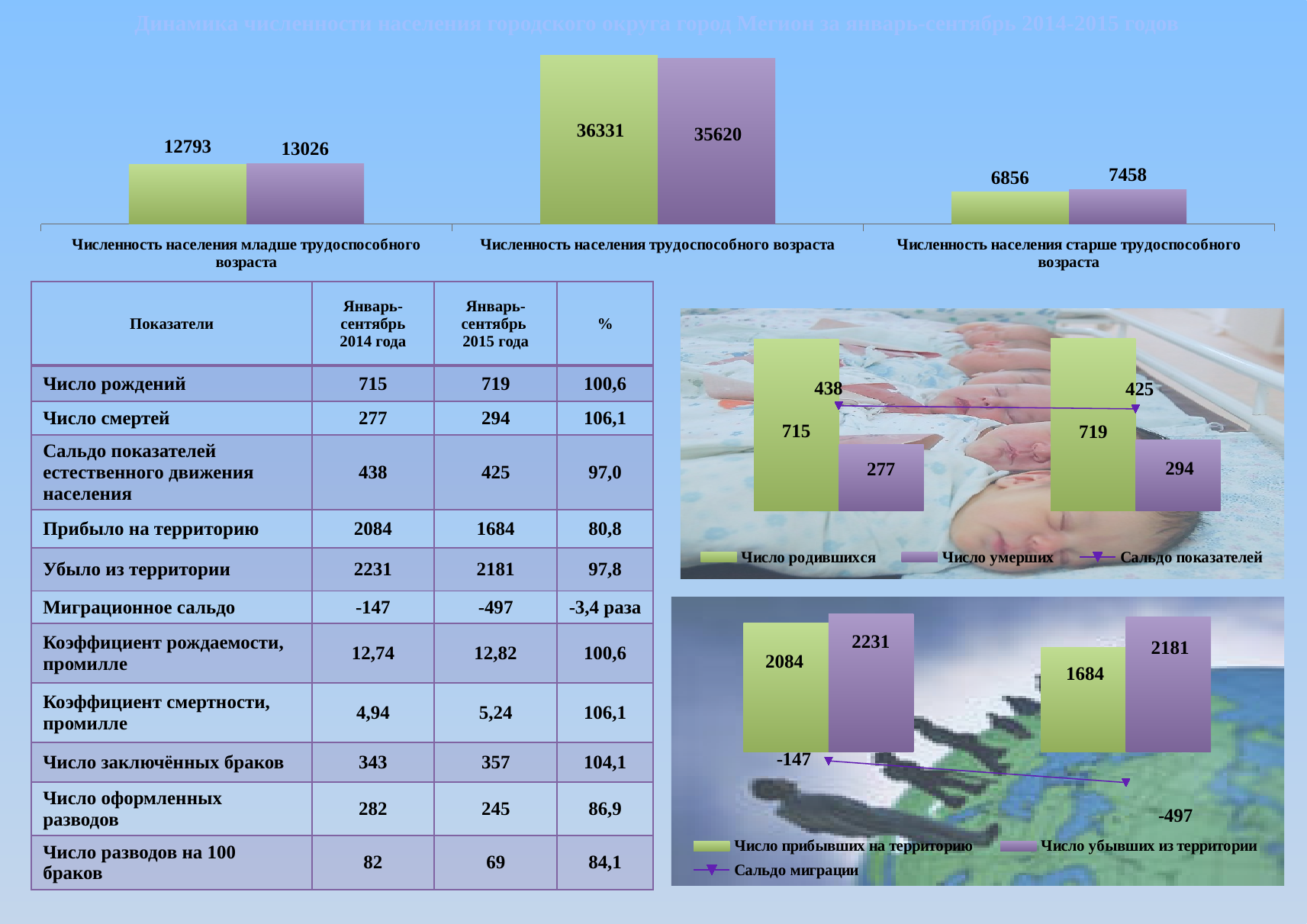
In the middle-right chart (births and deaths), how many series does the legend list? 3 In the middle-right chart (births and deaths), what is the difference between 'Число родившихся' and 'Число умерших' in the first group? 438 In the bottom-right chart (migration), what is the value of 'Сальдо миграции' for the second group? -497 In the bottom-right chart (migration), which is larger in the first group: 'Число прибывших на территорию' or 'Число убывших из территории'? Число убывших из территории In the top bar chart, what is the difference between the purple and green bars for 'Численность населения младше трудоспособного возраста'? 233 What kind of chart is the top chart on the slide? bar chart In the top bar chart, what is the value of the green bar for 'Численность населения трудоспособного возраста'? 36331 In the top bar chart, which category has the highest values? Численность населения трудоспособного возраста In the top bar chart, how many categories are shown on the x axis? 3 In the bottom-right chart (migration), does the 'Сальдо миграции' line rise or fall from the first group to the second? fall In the top bar chart, what is the value of the purple bar for 'Численность населения старше трудоспособного возраста'? 7458 In the middle-right chart (births and deaths), what is the value of 'Число умерших' for the second group? 294